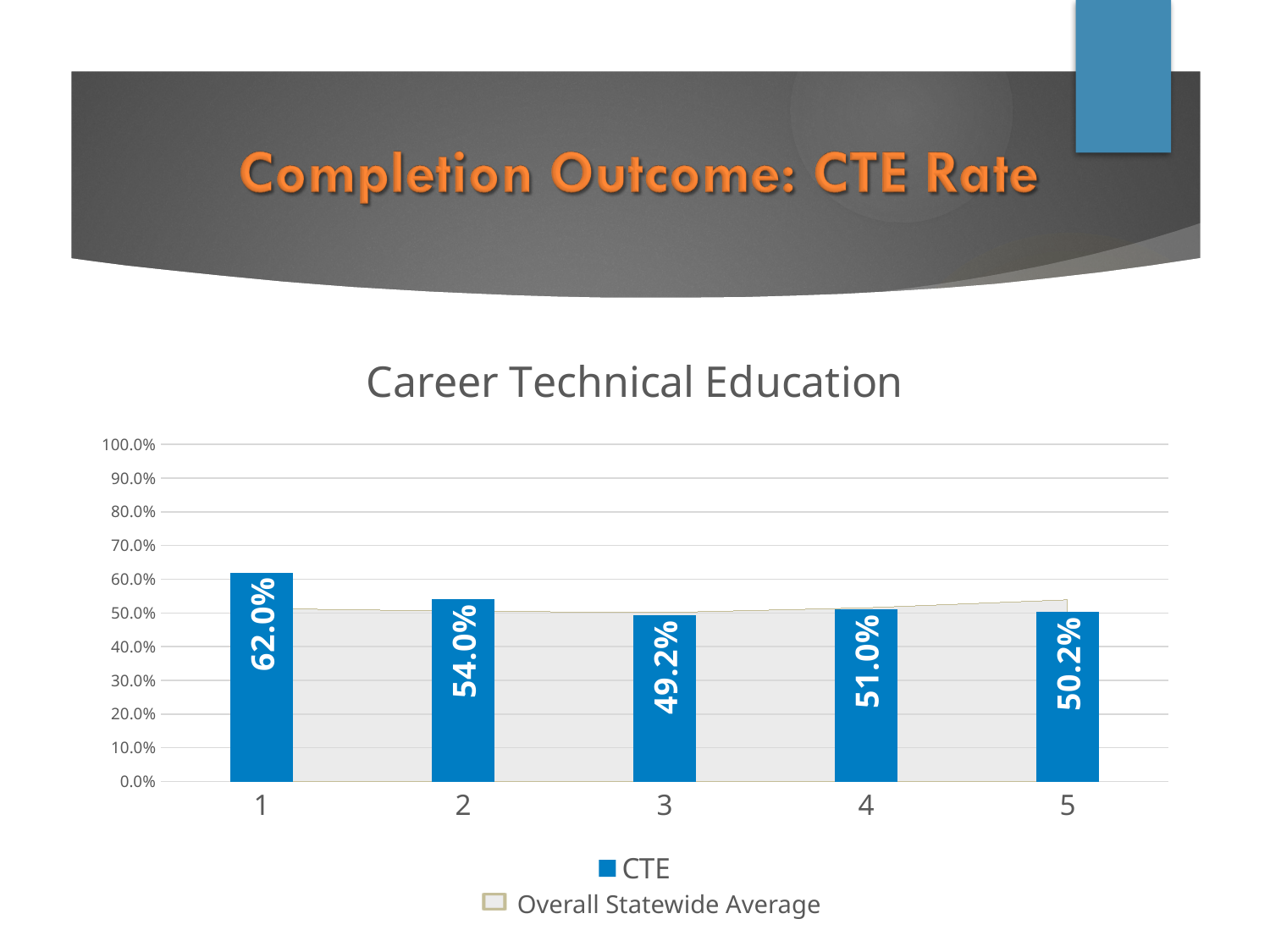
Which category has the lowest CTE value? 3 What is the difference between the CTE values for category 1 and category 2? 8.0% What is the CTE value for category 5? 50.2% Which is larger, the CTE value for category 2 or for category 4? Category 2 What kind of chart is used to show the CTE series? Bar chart Is the CTE value for category 1 greater or less than 60.0%? greater How many series does the legend list? 2 How many categories are shown on the x axis? 5 Which category has the highest CTE value? 1 What is the CTE value for category 1? 62.0% What is the CTE value for category 3? 49.2% What is the title of the chart? Career Technical Education